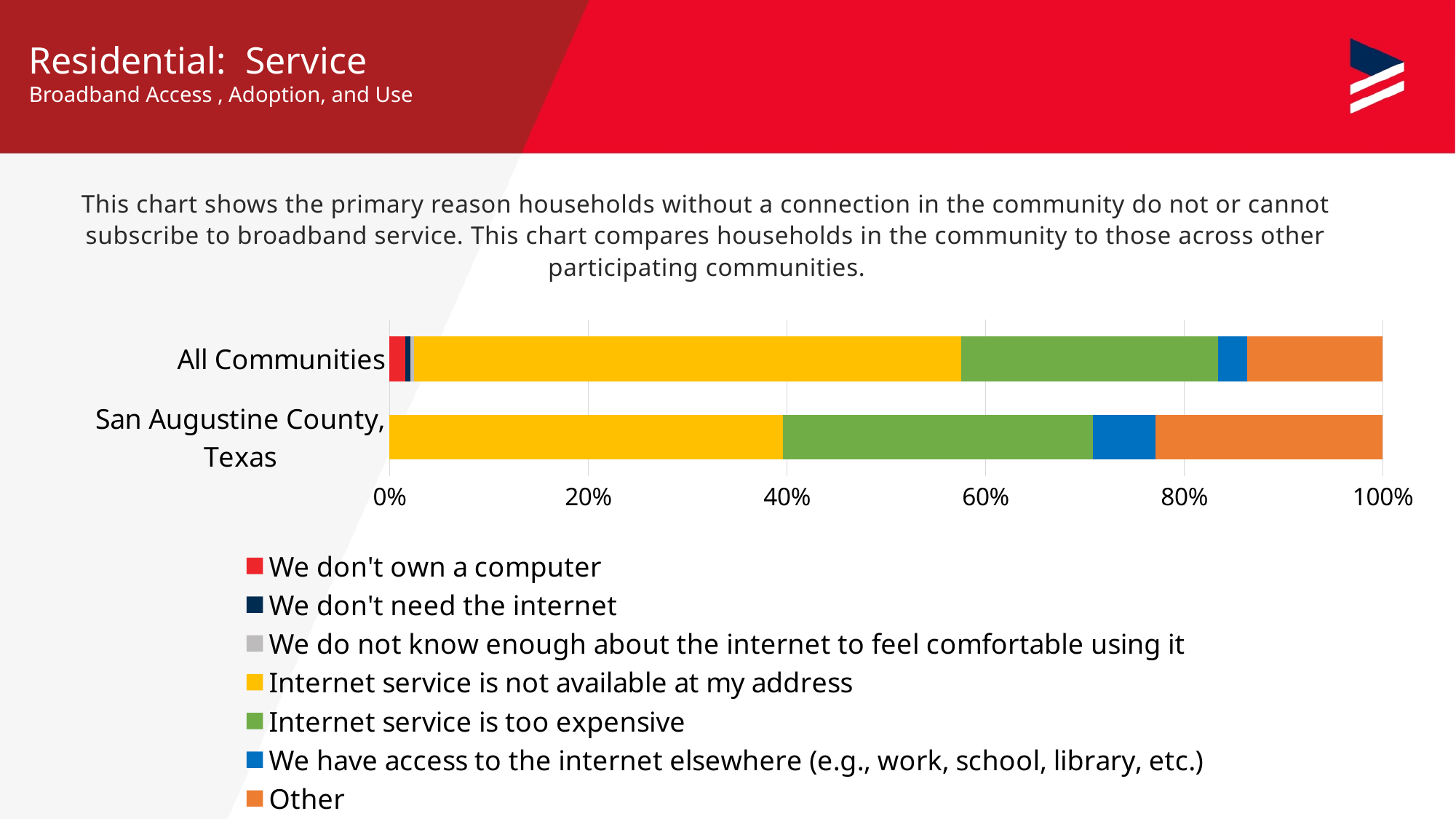
What colour represents "Other" in the legend? Orange Which reason makes up the largest segment of the San Augustine County, Texas bar? Internet service is not available at my address Is the cumulative share for All Communities at the end of the "Internet service is too expensive" segment greater or less than 80%? greater Is the cumulative share for All Communities at the end of the "Internet service is not available at my address" segment greater or less than 60%? less What kind of chart is shown on the slide? Stacked bar chart How many categories (bars) does the chart show? 2 How many series does the legend list? 7 Which category has the larger segment for "We have access to the internet elsewhere (e.g., work, school, library, etc.)", All Communities or San Augustine County, Texas? San Augustine County, Texas Is the cumulative share for San Augustine County, Texas at the end of the "Internet service is too expensive" segment greater or less than 60%? greater Which category has the larger "Other" segment, All Communities or San Augustine County, Texas? San Augustine County, Texas What is the total of each stacked bar in the chart? 100% Which category has the larger segment for "Internet service is not available at my address", All Communities or San Augustine County, Texas? All Communities